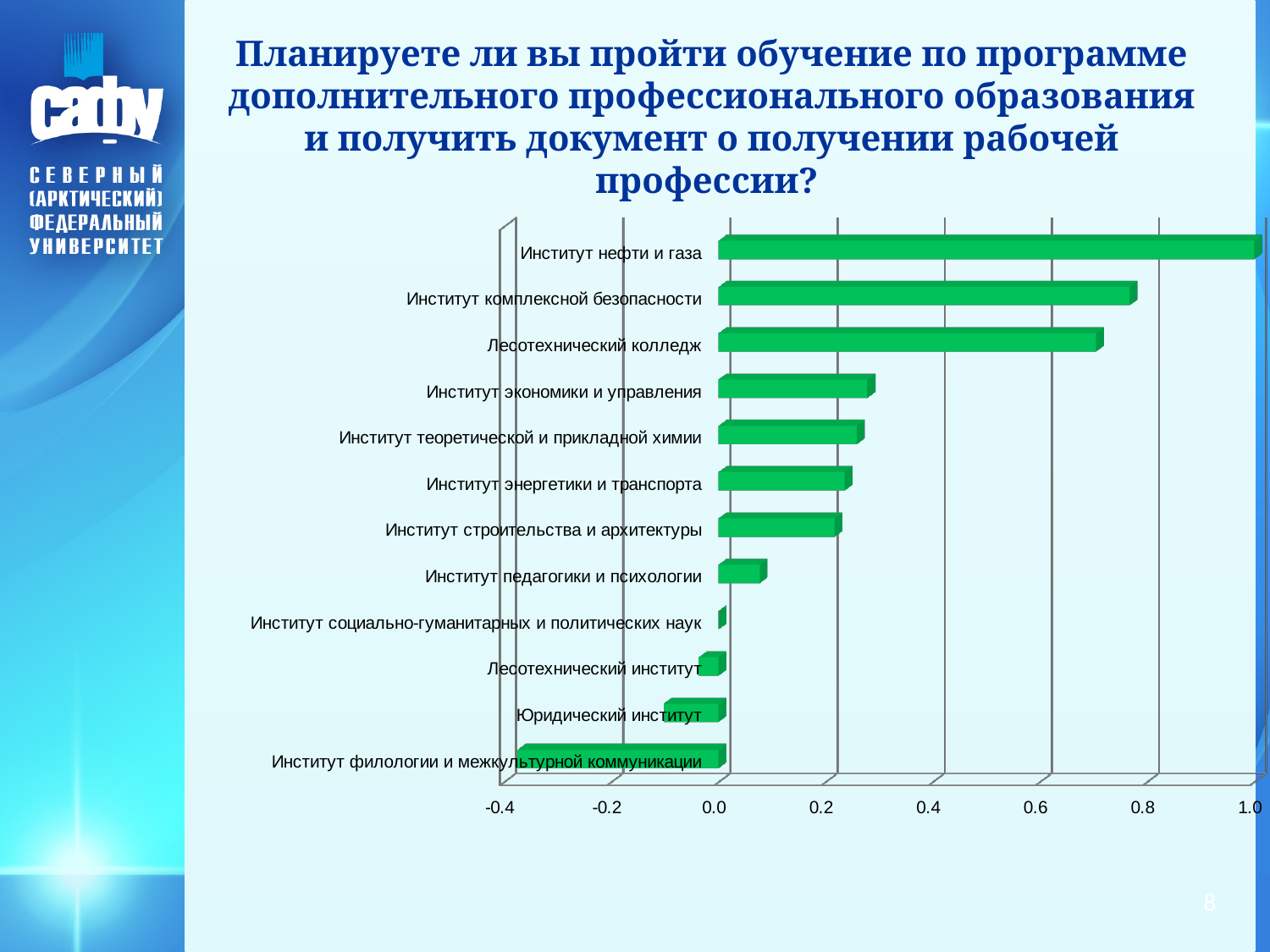
How many institutes (categories) are plotted in the chart? 12 Which has the larger value: Институт нефти и газа or Институт комплексной безопасности? Институт нефти и газа Is the value for Институт комплексной безопасности greater or less than 0.6? greater Is the value for Институт педагогики и психологии greater or less than 0.2? less Is the value for Институт экономики и управления greater or less than 0.2? greater What kind of chart is shown on the slide? bar chart Which has the larger value: Институт экономики и управления or Институт педагогики и психологии? Институт экономики и управления Which institute has the highest value in the chart? Институт нефти и газа What is the lowest value shown on the horizontal axis of the chart? -0.4 Which institute has the lowest value in the chart? Институт филологии и межкультурной коммуникации